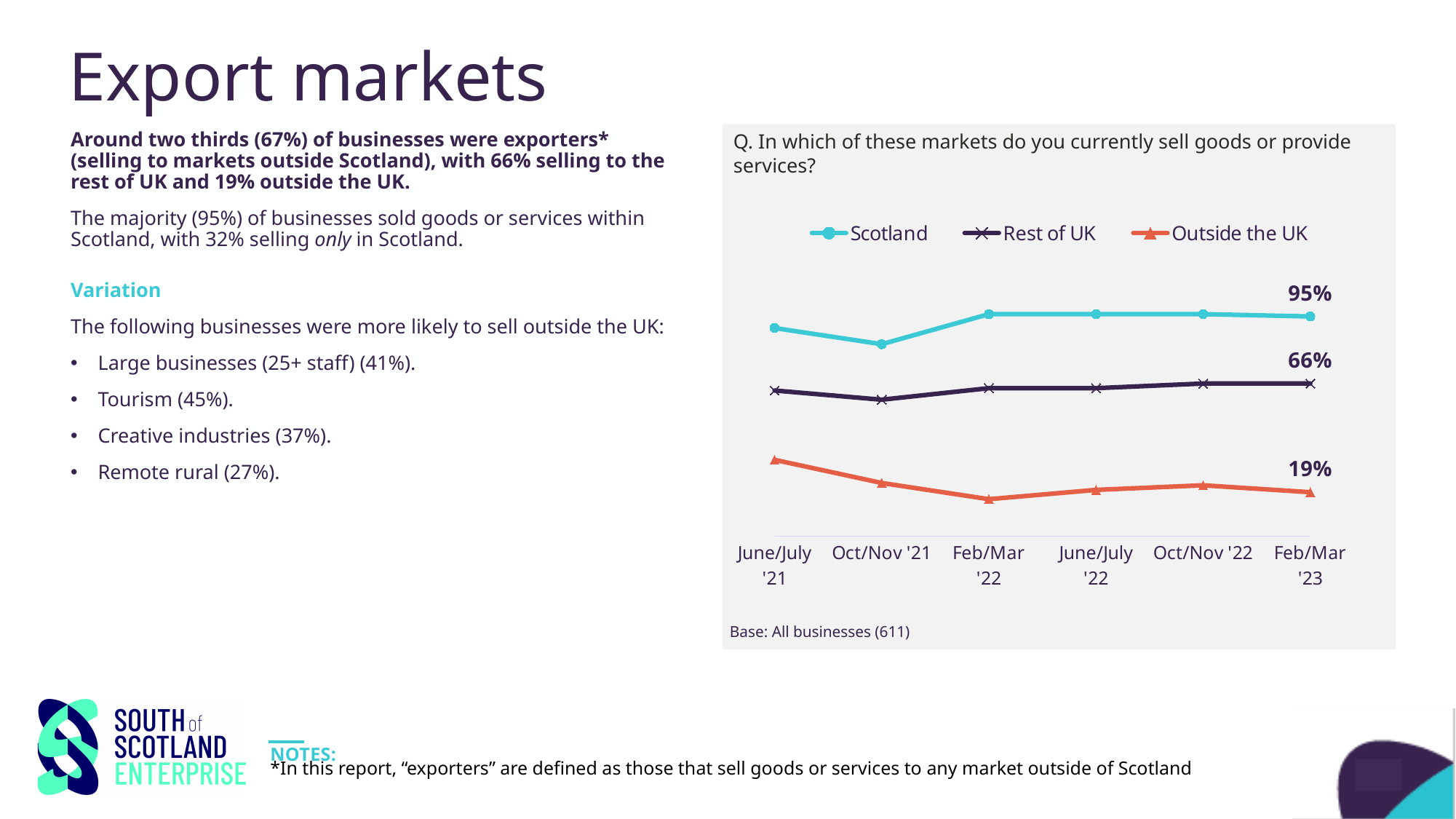
What is the value for Outside the UK at Feb/Mar '23? 19% What is the difference between the Rest of UK and Outside the UK values at Feb/Mar '23? 47 percentage points Which series has the lowest value at Feb/Mar '23? Outside the UK What is the value for Rest of UK at Feb/Mar '23? 66% What is the first time period shown on the x axis of the chart? June/July '21 How many time points are plotted along the x axis of the chart? 6 What is the value for Scotland at Feb/Mar '23? 95% Which is larger at Feb/Mar '23, the value for Rest of UK or the value for Outside the UK? Rest of UK What is the difference between the Scotland and Rest of UK values at Feb/Mar '23? 29 percentage points Which series has the highest value at Feb/Mar '23? Scotland How many series does the chart legend list? 3 What kind of chart is shown on the slide? line chart